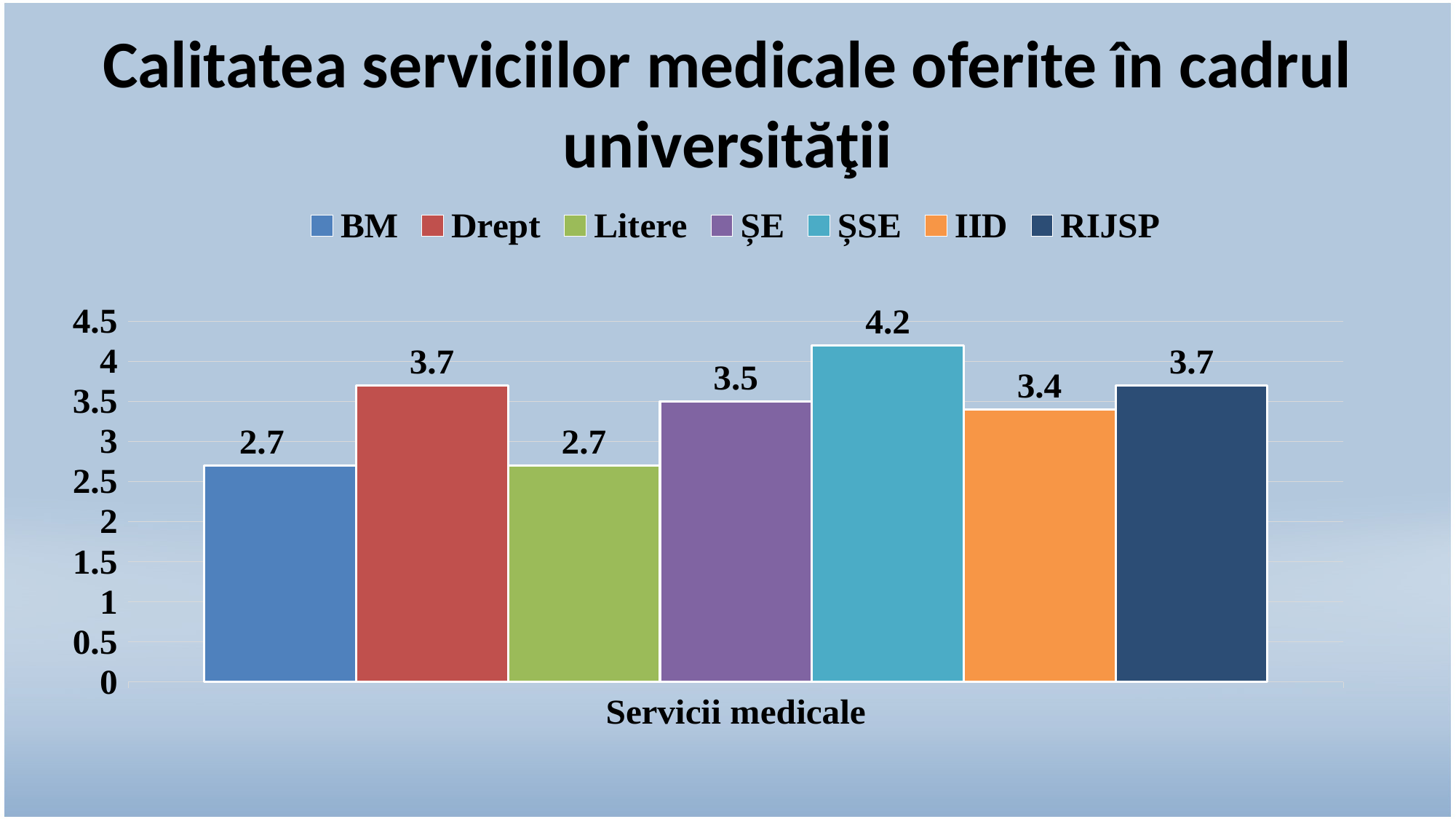
What is the value for IID? 3.4 What is the difference between the values for ȘSE and BM? 1.5 How many series does the legend list? 7 Is the value for RIJSP greater or less than 3? greater What is the label on the x axis of the chart? Servicii medicale Which series share the lowest value of 2.7? BM and Litere What is the value for ȘSE? 4.2 What is the value for ȘE? 3.5 What kind of chart is shown on the slide? bar chart Which is larger, the value for Drept or the value for ȘE? Drept Which series has the highest value? ȘSE What is the difference between the values for Drept and IID? 0.3